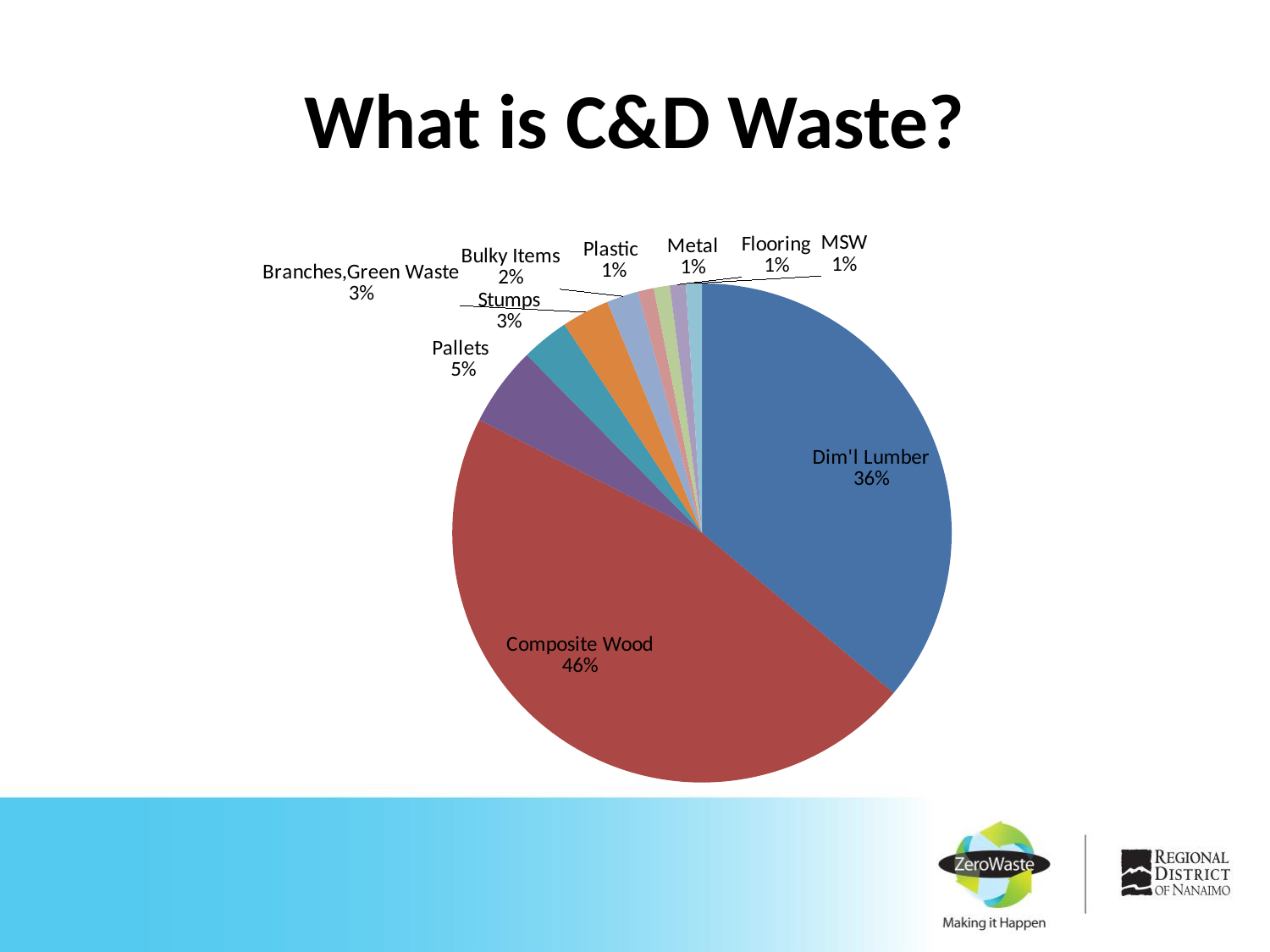
What share of C&D waste is Composite Wood? 46% Which category has the largest slice of the pie? Composite Wood What percentage is shown for Branches,Green Waste? 3% What is the difference in percentage points between Composite Wood and Dim'l Lumber? 10 What percentage of the pie is Pallets? 5% How many categories are shown in the pie chart? 10 What share of C&D waste is Dim'l Lumber? 36% What percentage is shown for Bulky Items? 2% Which is larger, the share for Pallets or the share for Stumps? Pallets What percentage is shown for Stumps? 3% What kind of chart is shown on the slide? Pie chart What is the title of the slide containing the pie chart? What is C&D Waste?